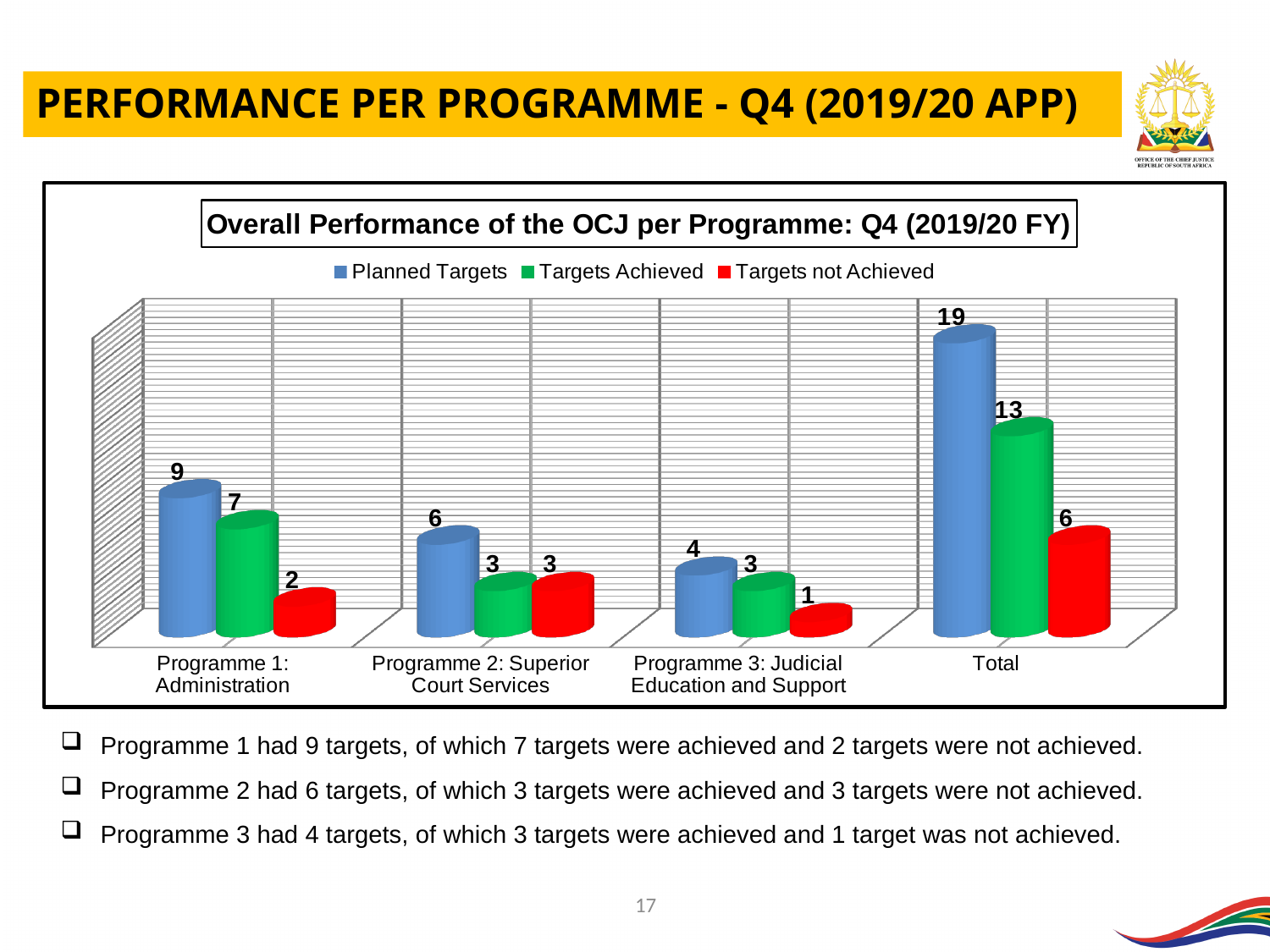
What kind of chart is shown on the slide? Bar chart What is the value of Planned Targets for Programme 1: Administration? 9 How many categories are shown on the x axis? 4 Which category has the highest Planned Targets value? Total What is the value of Targets Achieved for Total? 13 How many series does the legend list? 3 What is the value of Targets not Achieved for Programme 3: Judicial Education and Support? 1 Which is larger for Programme 3: Judicial Education and Support, Targets Achieved or Targets not Achieved? Targets Achieved What is the value of Targets Achieved for Programme 2: Superior Court Services? 3 What is the title of the chart? Overall Performance of the OCJ per Programme: Q4 (2019/20 FY) Which category has the lowest Targets not Achieved value? Programme 3: Judicial Education and Support What is the difference between Planned Targets and Targets Achieved for Programme 1: Administration? 2